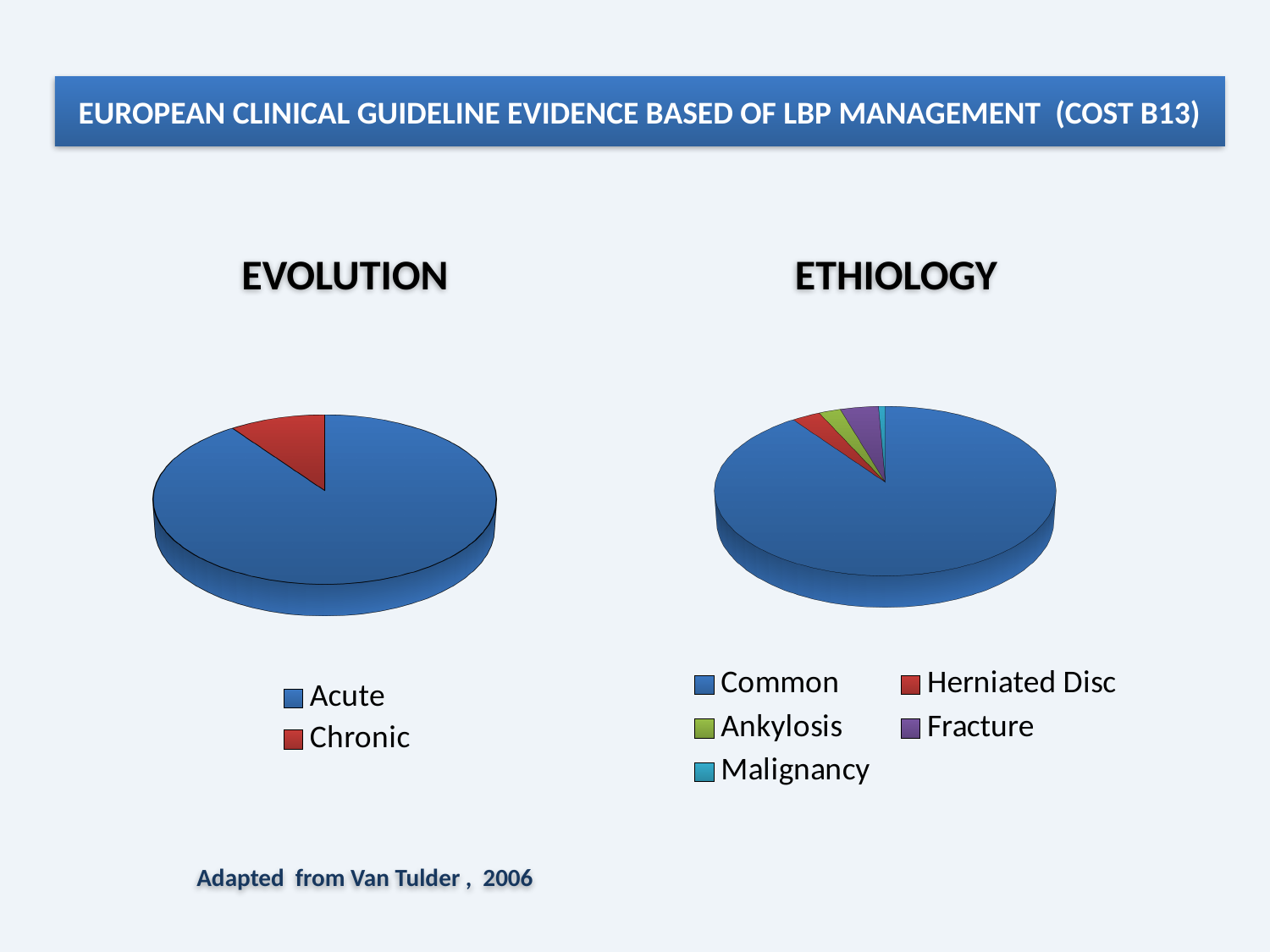
In the ETHIOLOGY chart, how many categories does the legend list? 5 In the EVOLUTION chart, which category has the largest slice? Acute In the EVOLUTION chart, how many categories does the legend list? 2 In the EVOLUTION chart, what colour is the Chronic slice? Red What kind of chart is the ETHIOLOGY chart? Pie chart In the EVOLUTION chart, which category has the smallest slice? Chronic In the ETHIOLOGY chart, which category has the smallest slice? Malignancy In the ETHIOLOGY chart, which category is shown in purple? Fracture In the ETHIOLOGY chart, which category has the largest slice? Common In the ETHIOLOGY chart, which slice is larger, Common or Fracture? Common What kind of chart is the EVOLUTION chart? Pie chart In the ETHIOLOGY chart, which slice is larger, Fracture or Malignancy? Fracture